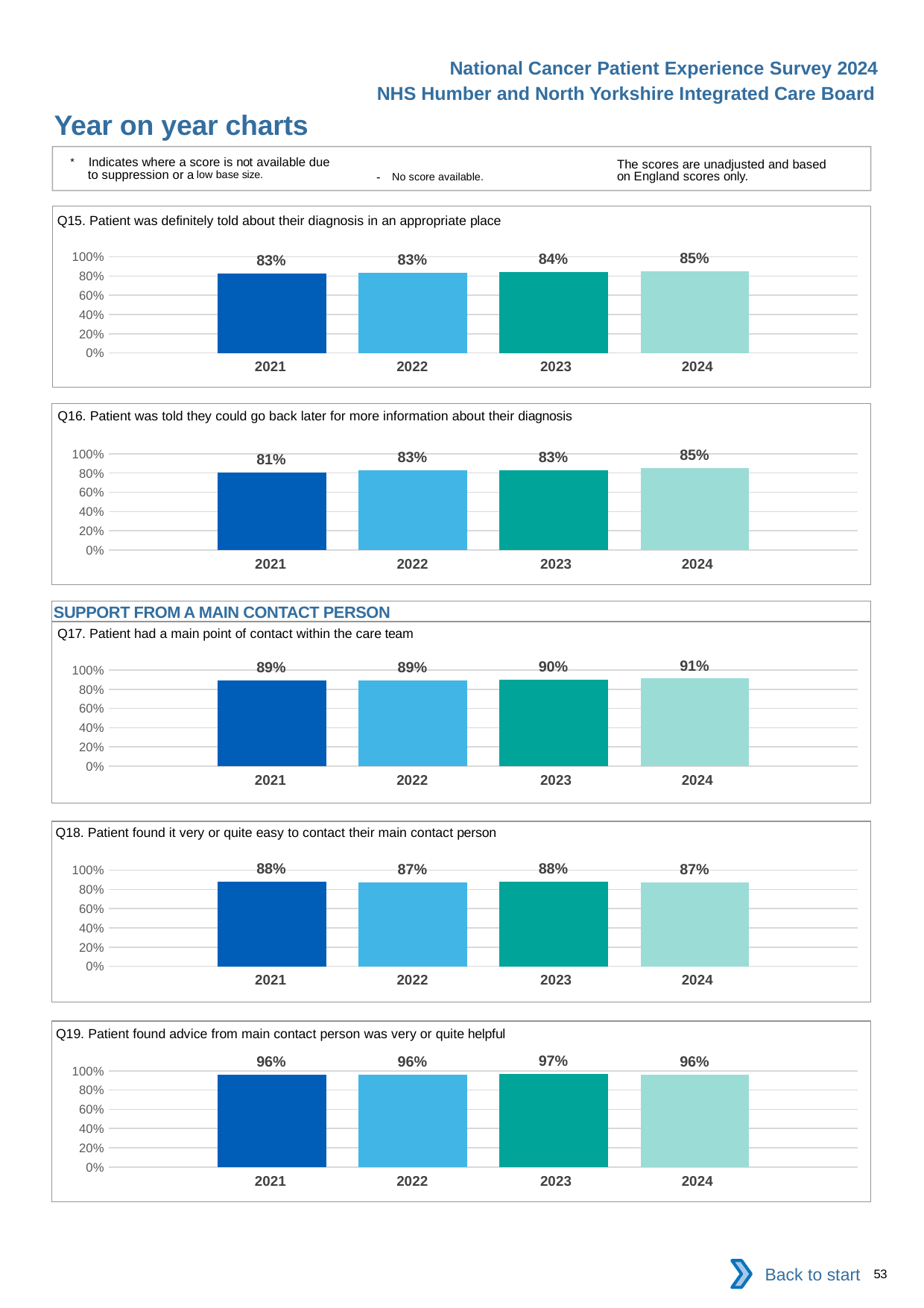
In the Q17 chart, what is the value for 2023? 90% In the Q16 chart, which year has the lowest value? 2021 In the Q16 chart, which year has the highest value? 2024 In the Q16 chart, what is the value for 2021? 81% In the Q19 chart, which year has the highest value? 2023 What kind of chart is the Q15 chart? Bar chart In the Q16 chart, do the values rise or fall from 2021 to 2024? Rise How many years are shown in the Q19 chart? 4 In the Q17 chart, what is the difference between the 2024 and 2021 values? 2% In the Q15 chart, what is the value for 2024? 85% In the Q18 chart, which is larger, the value for 2021 or the value for 2022? 2021 In the Q18 chart, is the value for 2024 greater or less than 80%? greater